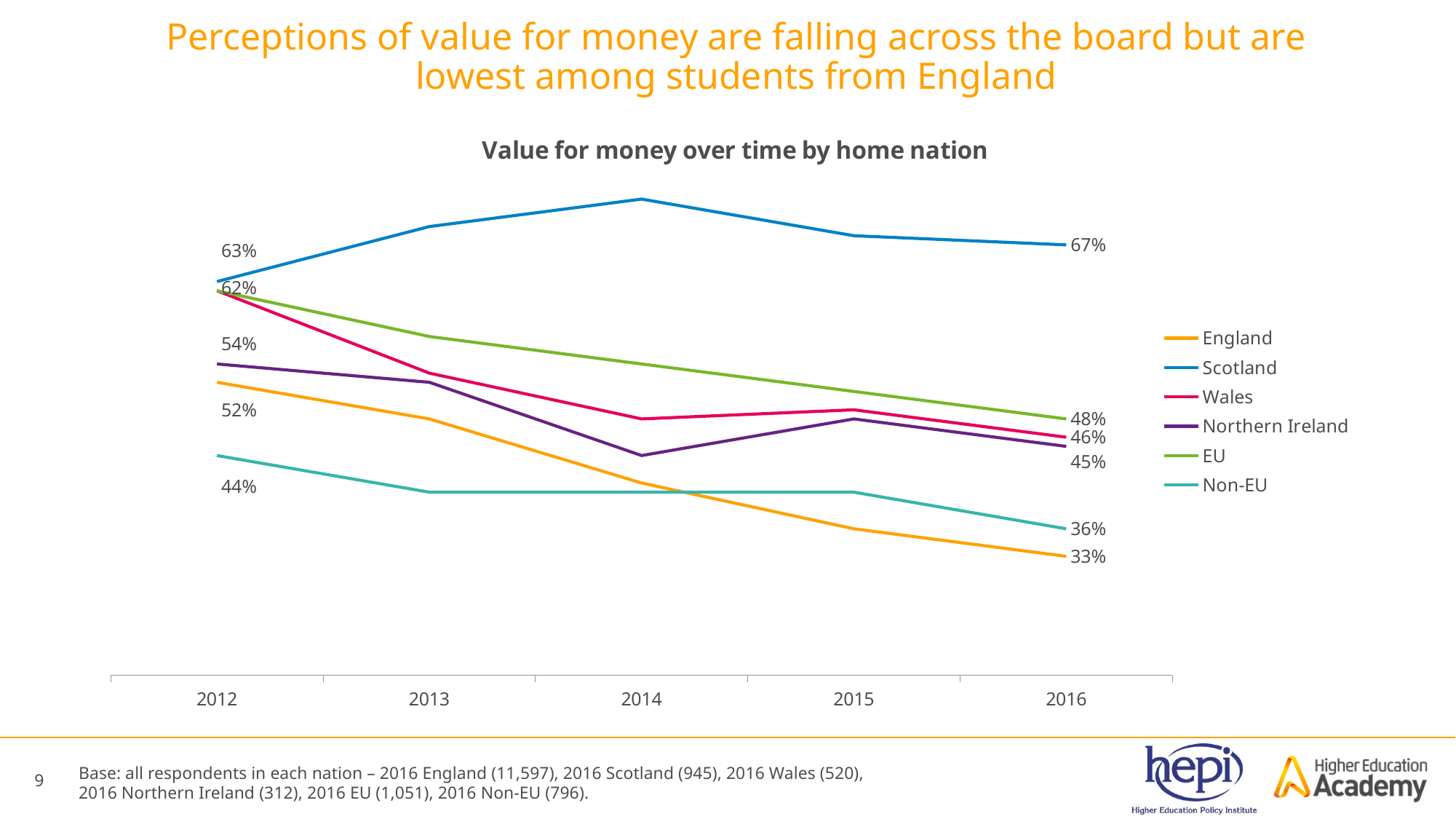
What is the difference between the 2016 values for Scotland and England? 34% What is the value for England in 2012? 52% What is the value for Non-EU in 2016? 36% What is the value for Scotland in 2016? 67% Which home nation has the lowest value in 2016? England How many years are shown on the x axis? 5 What kind of chart is shown on the slide? line chart Which home nation has the highest value in 2016? Scotland How many series does the legend list? 6 What is the value for England in 2016? 33% Does the value for England rise or fall from 2012 to 2016? fall What is the value for EU in 2016? 48%